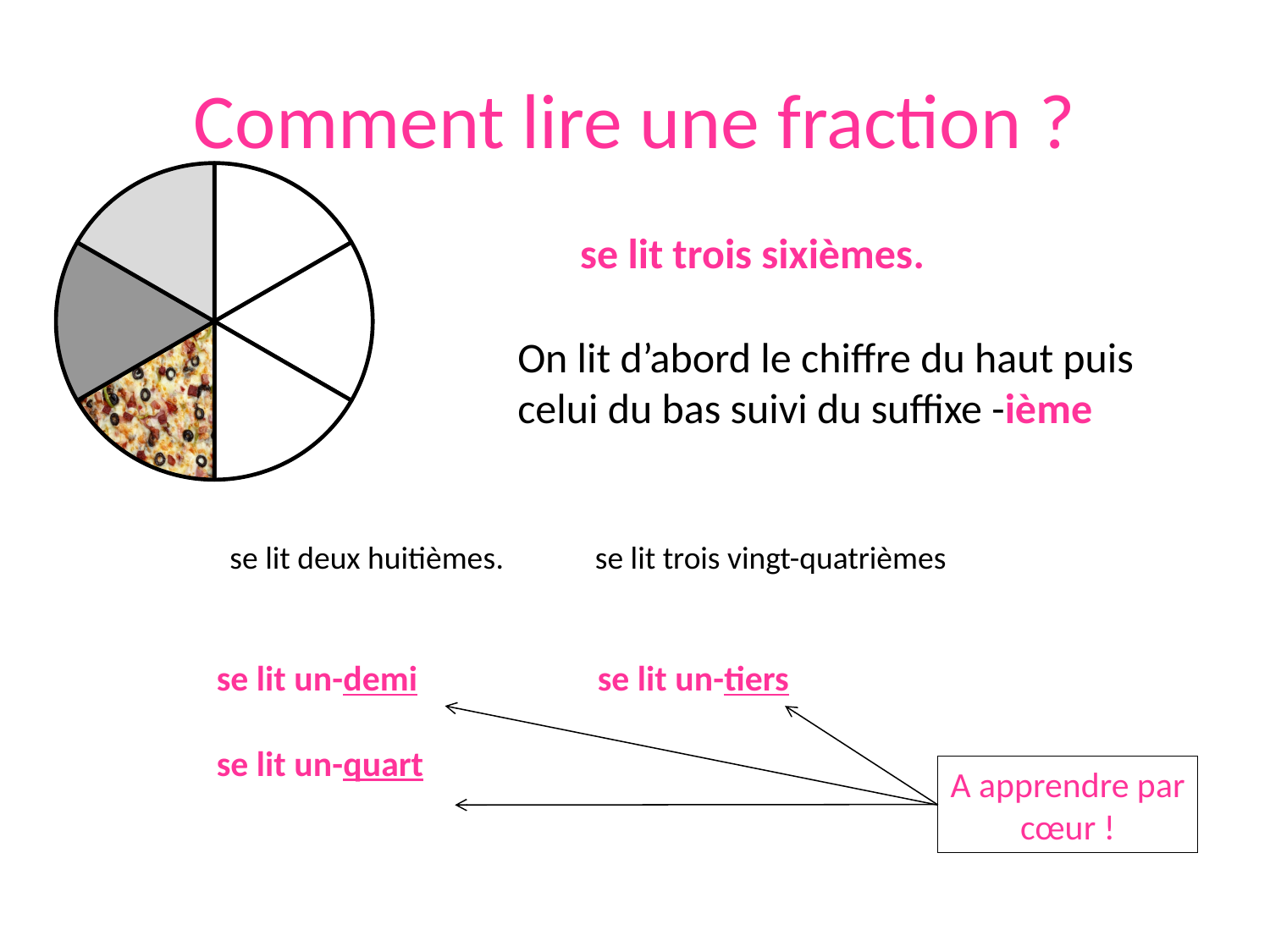
How many slices of the circle are shaded or filled (not white)? 3 What fraction of the circle do the three filled slices represent, as read on the slide? trois sixièmes What kind of chart is shown on the left of the slide? pie chart What is the title of the slide containing the circle diagram? Comment lire une fraction ? How many slices of the circle are filled with a pizza image? 1 How many equal slices is the circle on the left divided into? 6 Are the filled slices of the circle more or less than half of the circle, or exactly half? exactly half